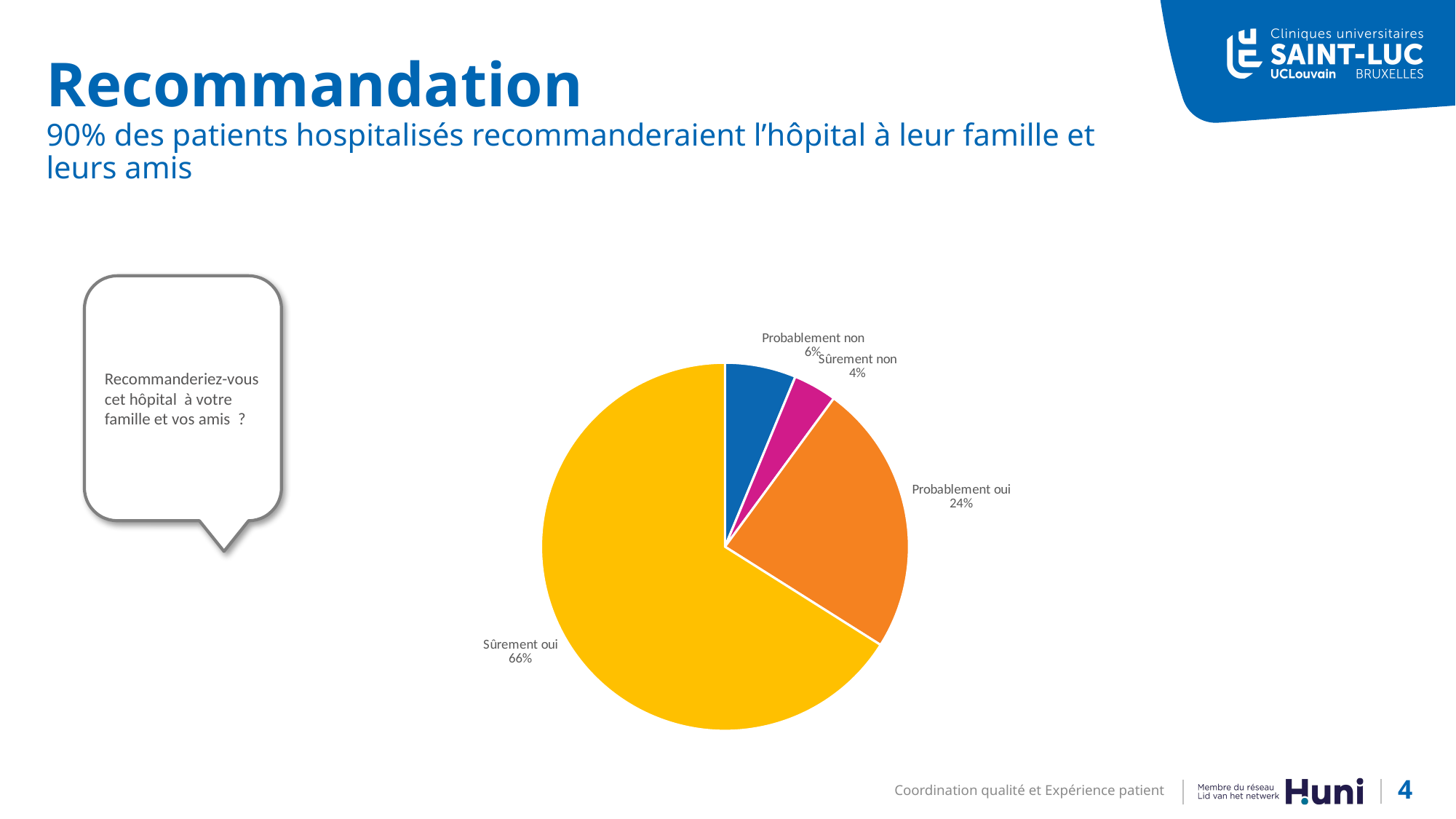
Which slice of the pie is the largest? Sûrement oui What share of the pie is labelled "Sûrement oui"? 66% How many slices does the pie chart have? 4 Which is larger, the "Probablement non" slice or the "Sûrement non" slice? Probablement non What share of the pie is labelled "Probablement oui"? 24% What colour is the "Sûrement oui" slice? Yellow What share of the pie is labelled "Probablement non"? 6% What is the difference in percentage points between "Sûrement oui" and "Probablement oui"? 42 What is the combined share of "Sûrement oui" and "Probablement oui"? 90% Which slice of the pie is the smallest? Sûrement non What kind of chart is shown on the slide? Pie chart